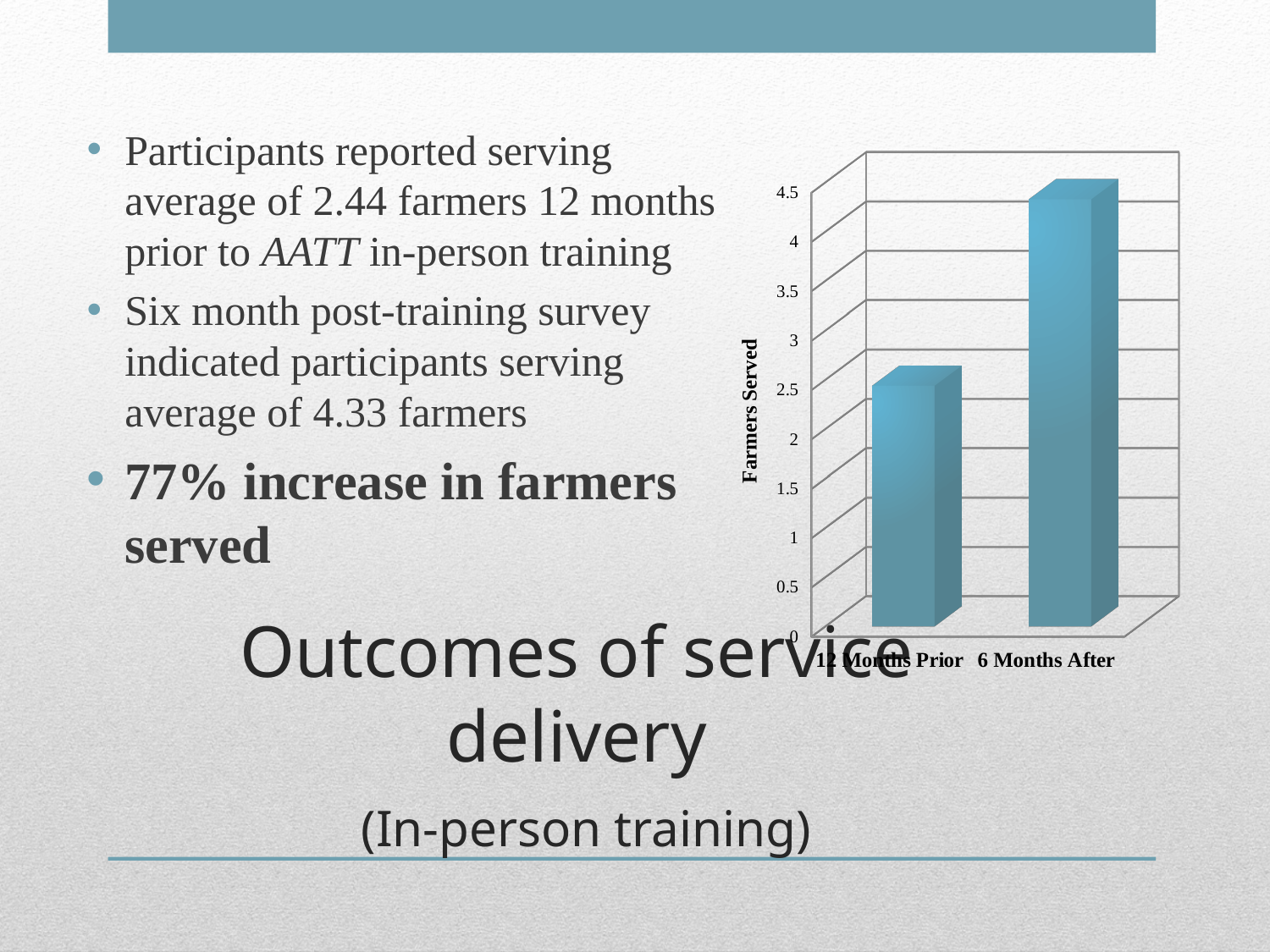
Is the value for 6 Months After greater or less than 3.5? greater What is the title of the vertical axis on the chart? Farmers Served Is the value for 12 Months Prior greater or less than 2? greater Is the value for 6 Months After greater or less than 4? greater Which category has the highest value on the chart? 6 Months After What is the highest tick value shown on the vertical axis of the chart? 4.5 Do the values rise or fall from 12 Months Prior to 6 Months After? rise Which category has the lowest value on the chart? 12 Months Prior Which is larger on the chart, the value for 12 Months Prior or the value for 6 Months After? 6 Months After What kind of chart is shown on the slide? bar chart How many categories are plotted on the chart? 2